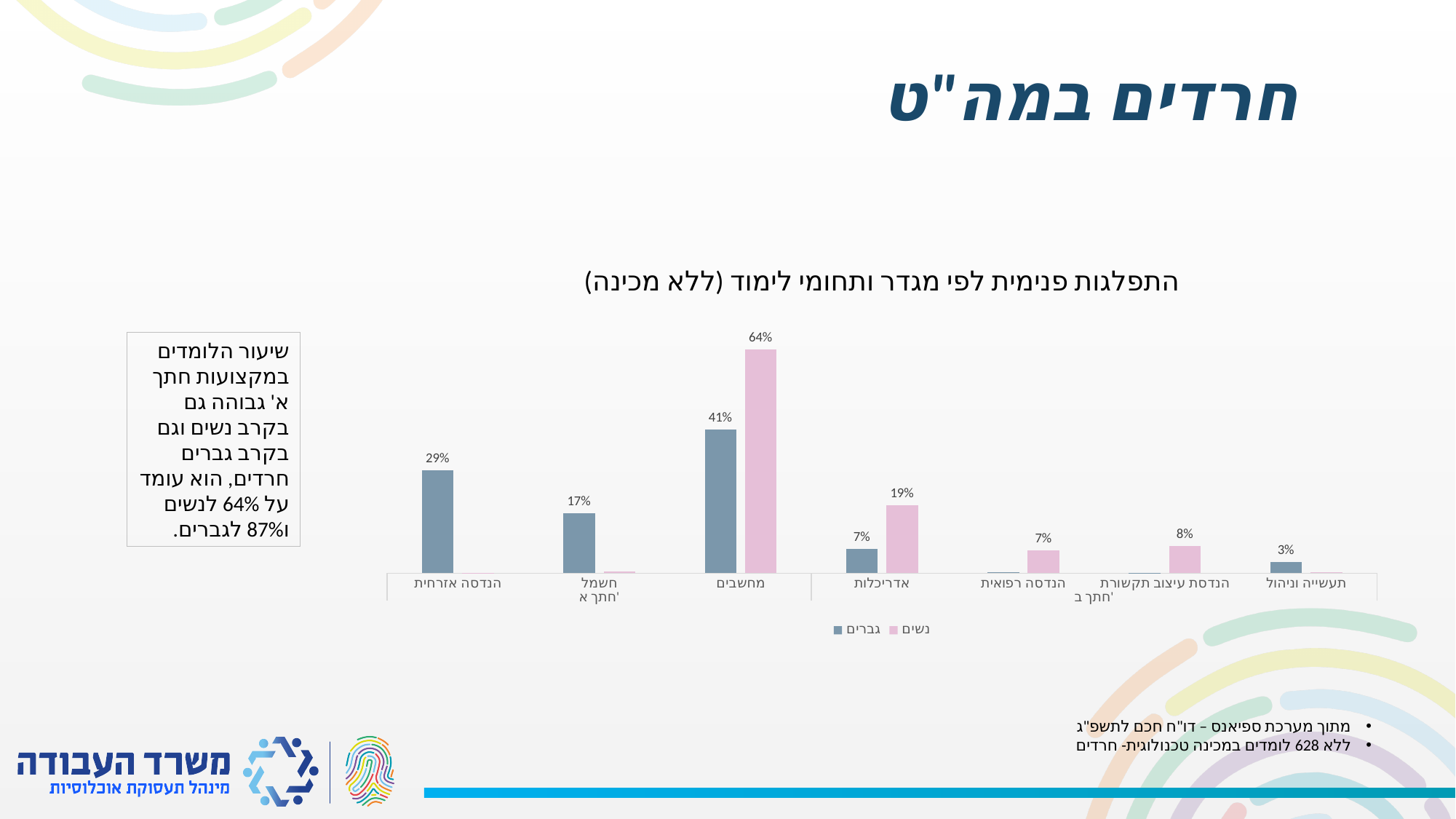
How many series does the legend list? 2 Which category has the highest value for נשים? מחשבים How many categories are shown on the x axis? 7 Which is larger in the אדריכלות category: the value for גברים or for נשים? נשים Which category has the highest value for גברים? מחשבים What kind of chart is shown on the slide? bar chart What is the value for נשים in the אדריכלות category? 19% What is the difference between the נשים and גברים values in the מחשבים category? 23% What is the value for גברים in the הנדסה אזרחית category? 29% What is the value for גברים in the מחשבים category? 41% What is the value for נשים in the מחשבים category? 64% What is the value for גברים in the תעשייה וניהול category? 3%